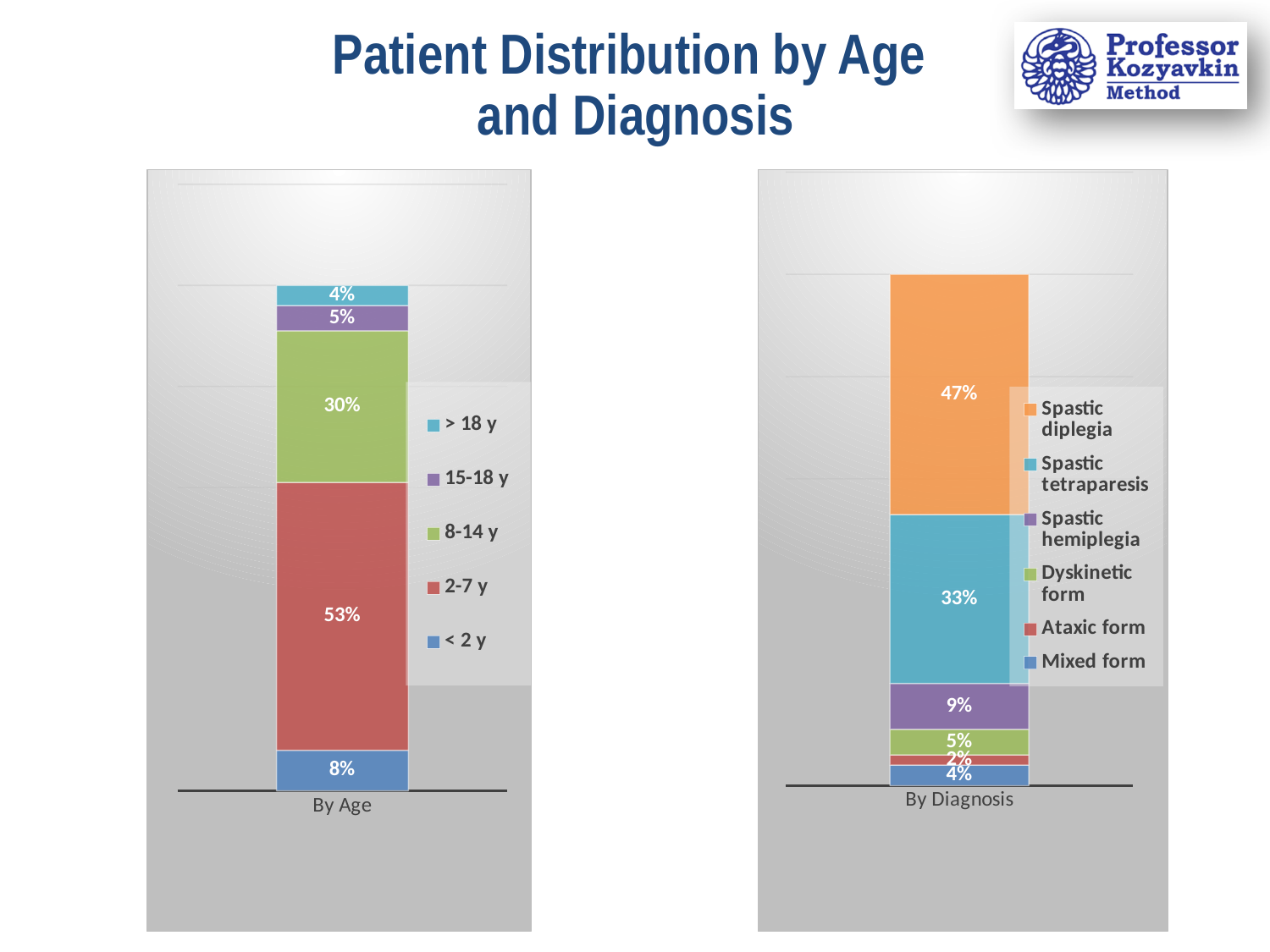
In the left chart (By Age), which age group has the smallest share of patients? > 18 y In the left chart (By Age), what is the difference between the 2-7 y share and the 8-14 y share? 23% In the left chart (By Age), how many series does the legend list? 5 In the left chart (By Age), which age group has the largest share of patients? 2-7 y What type of chart is used on the right side of the slide (By Diagnosis)? Stacked bar chart In the right chart (By Diagnosis), what percentage of patients have spastic hemiplegia? 9% In the right chart (By Diagnosis), what percentage of patients have spastic diplegia? 47% In the right chart (By Diagnosis), which is larger: the share for spastic tetraparesis or the share for spastic diplegia? Spastic diplegia In the left chart (By Age), what percentage of patients are aged 8-14 y? 30% In the right chart (By Diagnosis), what is the combined share of spastic diplegia and spastic tetraparesis? 80% In the right chart (By Diagnosis), which diagnosis has the smallest share of patients? Ataxic form In the left chart (By Age), what percentage of patients are aged 2-7 y? 53%